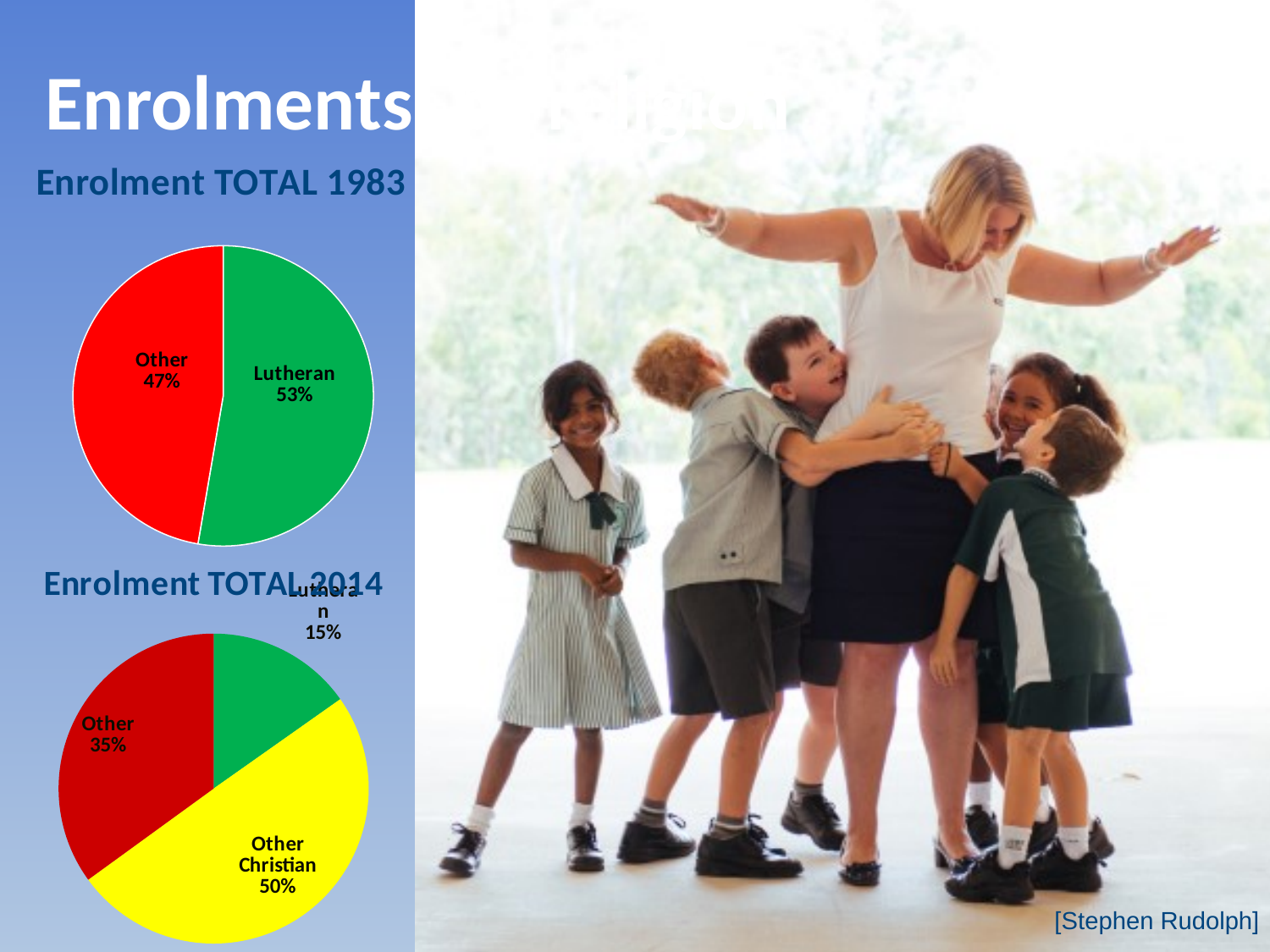
In the Enrolment TOTAL 2014 chart, what share of enrolments is Lutheran? 15% In the Enrolment TOTAL 1983 chart, what share of enrolments is Lutheran? 53% In the Enrolment TOTAL 2014 chart, what share of enrolments is Other Christian? 50% In the Enrolment TOTAL 2014 chart, which category has the largest share? Other Christian In the Enrolment TOTAL 1983 chart, how many slices does the pie have? 2 In the Enrolment TOTAL 2014 chart, how many slices does the pie have? 3 What is the difference between the Lutheran share in the Enrolment TOTAL 1983 chart and the Lutheran share in the Enrolment TOTAL 2014 chart? 38% In the Enrolment TOTAL 1983 chart, what share of enrolments is Other? 47% In the Enrolment TOTAL 2014 chart, which category has the smallest share? Lutheran In the Enrolment TOTAL 1983 chart, which slice is larger, Lutheran or Other? Lutheran In the Enrolment TOTAL 2014 chart, what share of enrolments is Other? 35% What kind of chart is the Enrolment TOTAL 1983 chart? Pie chart